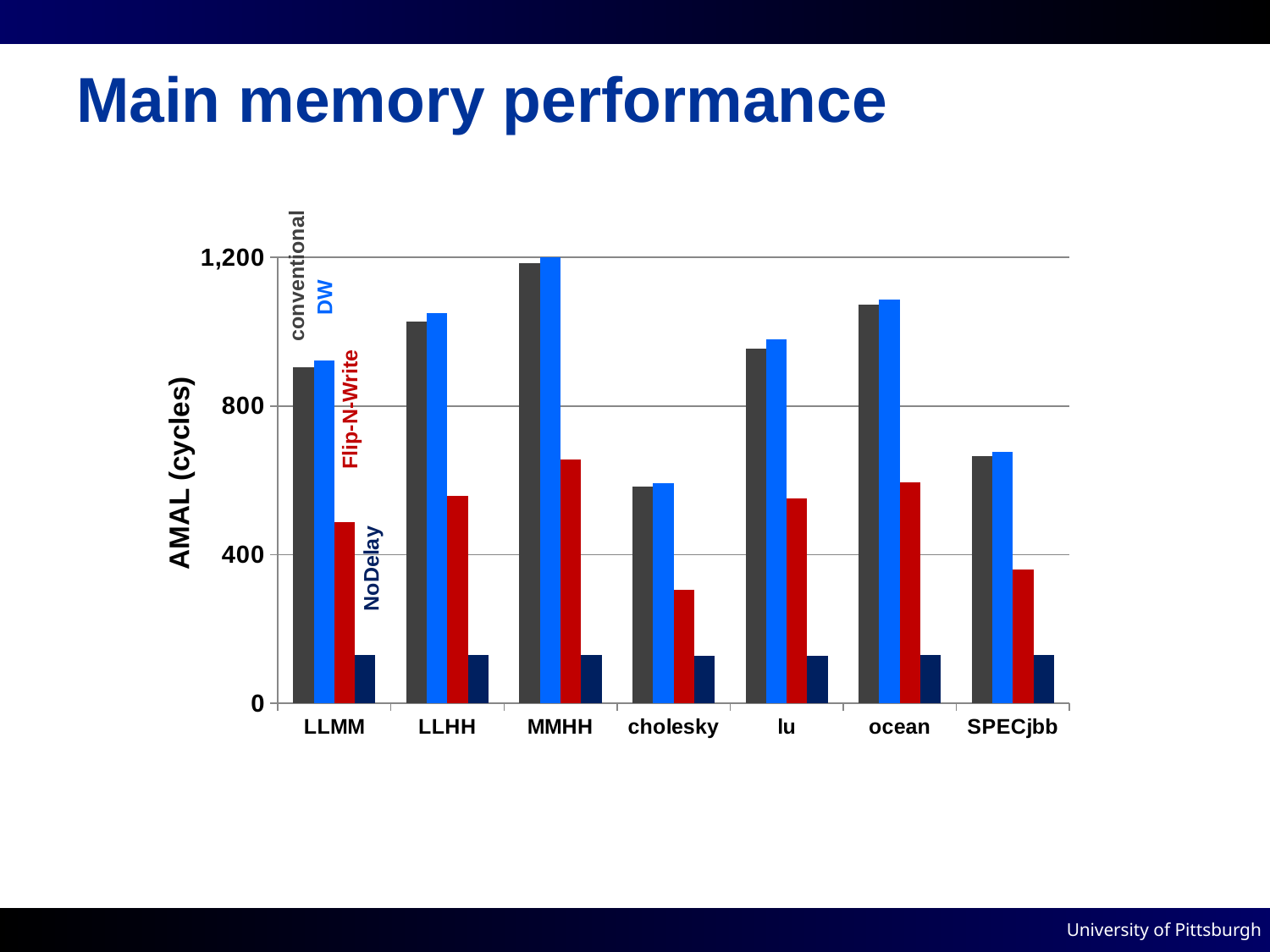
Which series is drawn in red? Flip-N-Write Which category has the highest conventional value? MMHH Is the Flip-N-Write value for cholesky greater or less than 400? less Which category has the lowest conventional value? cholesky Which series has the lowest value in every category? NoDelay Is the Flip-N-Write value for MMHH greater or less than 800? less How many series does the chart show? 4 What kind of chart is shown on the slide? bar chart How many benchmark categories are shown on the x axis? 7 Which is larger, the conventional value for LLMM or for LLHH? LLHH What is the label of the y axis? AMAL (cycles) Is the conventional value for LLMM greater or less than 800? greater